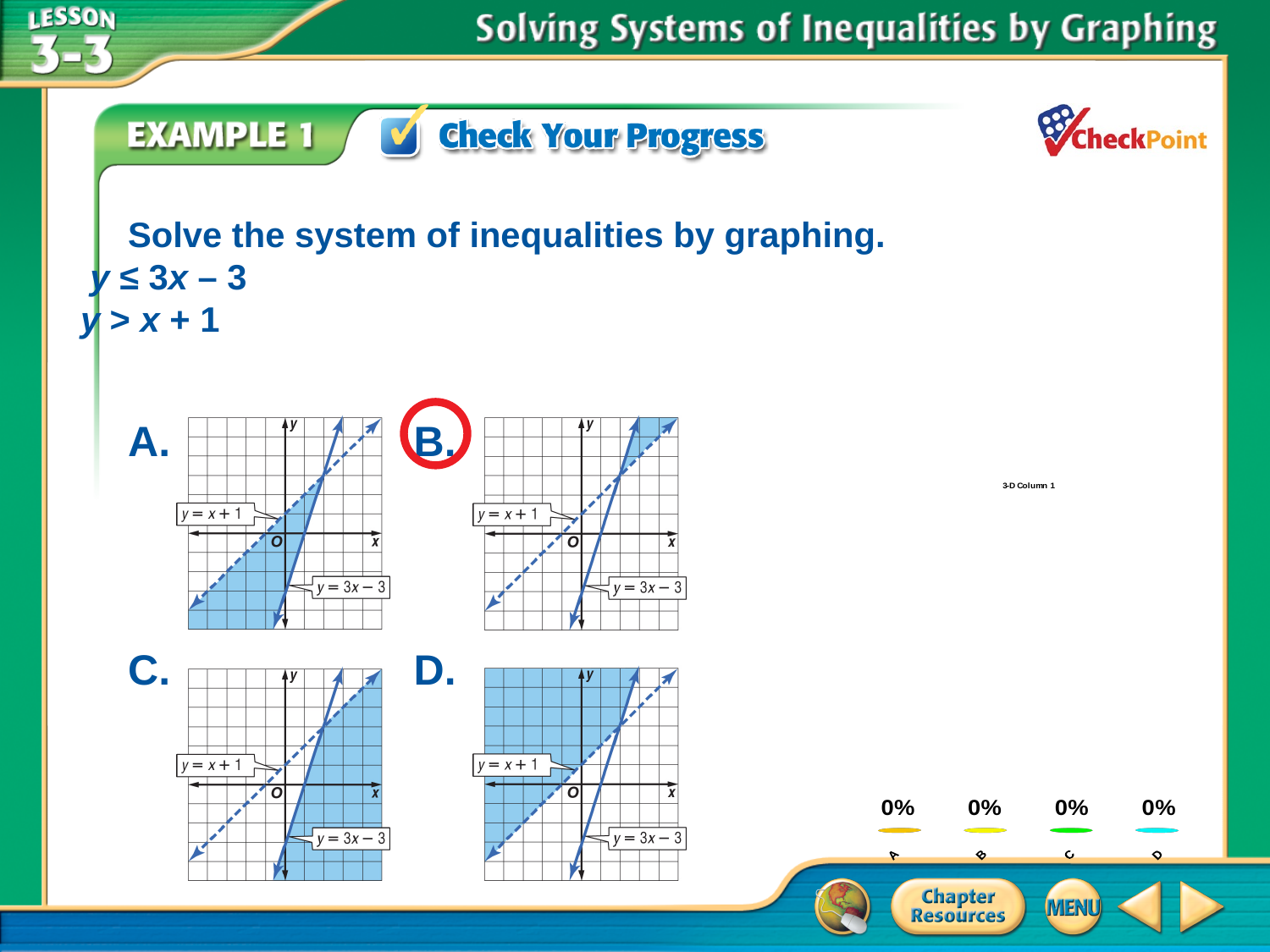
In the bar chart at the bottom right, what is the difference between the values for A and D? 0% In the bar chart at the bottom right, what is the value shown for category C? 0% What are the category labels along the x axis of the bar chart at the bottom right? A, B, C, D What kind of chart is shown at the bottom right of the slide? bar chart In the bar chart at the bottom right, what is the value shown for category A? 0% What is the title printed above the bar chart at the bottom right? 3-D Column 1 In the bar chart at the bottom right, what is the value shown for category B? 0% How many categories does the bar chart at the bottom right have? 4 In the bar chart at the bottom right, what is the value shown for category D? 0%